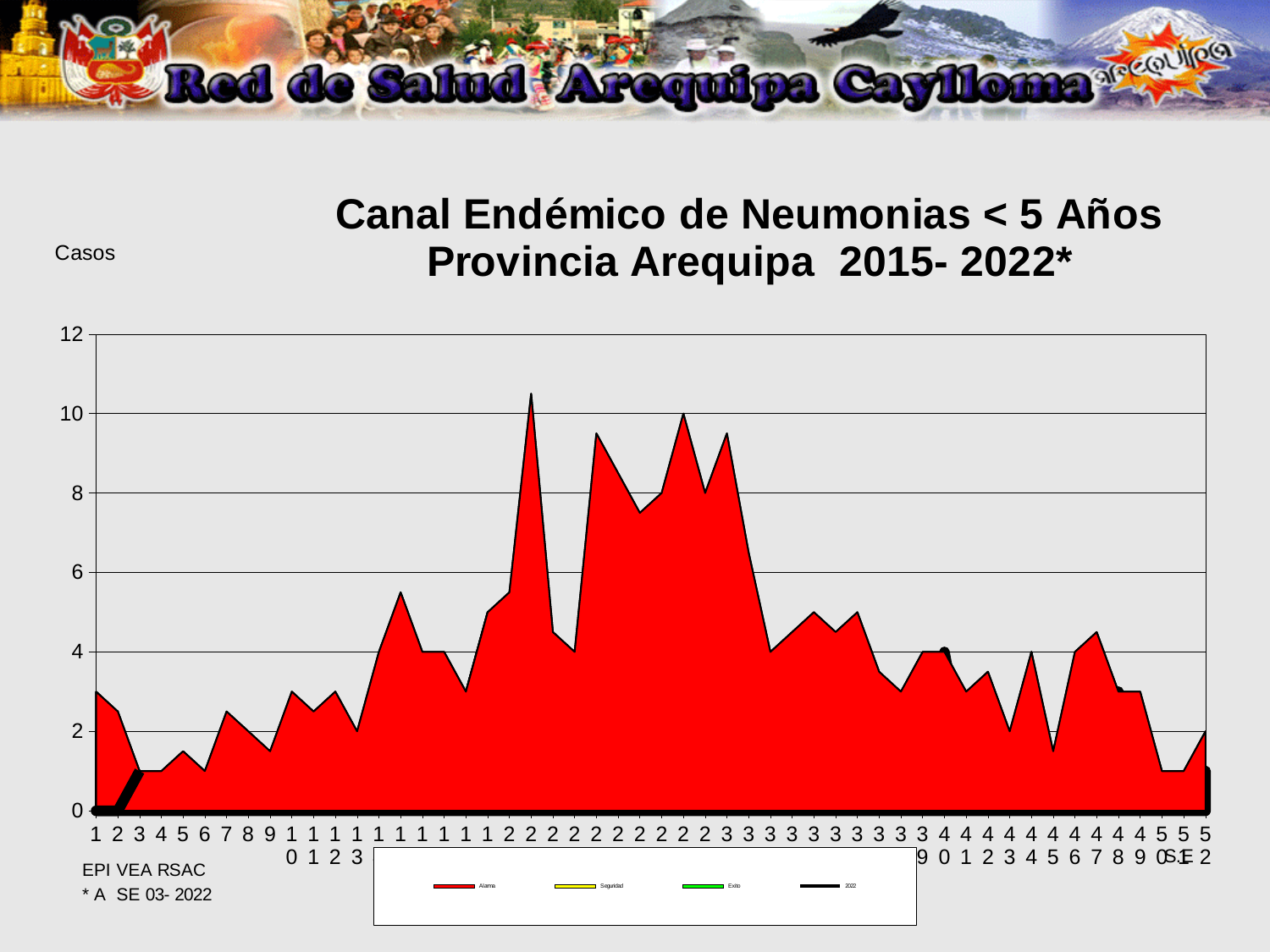
How many series does the legend list? 4 Is the value of the red Alarma area at week 40 greater or less than 2? greater Is the value of the red Alarma area at week 50 greater or less than 2? less What kind of chart is shown on the slide? Area chart How many weeks (categories) are shown along the x axis? 52 At which week does the red Alarma area reach its highest value? Week 21 What are the entries listed in the chart legend? Alarma, Seguridad, Exito, 2022 From week 1 to week 24, does the red Alarma area generally rise or fall? Rise Is the value of the red Alarma area at week 24 greater or less than 8? greater Which is larger, the red Alarma value at week 24 or at week 12? Week 24 What is the title of the chart? Canal Endémico de Neumonias < 5 Años Provincia Arequipa 2015- 2022*